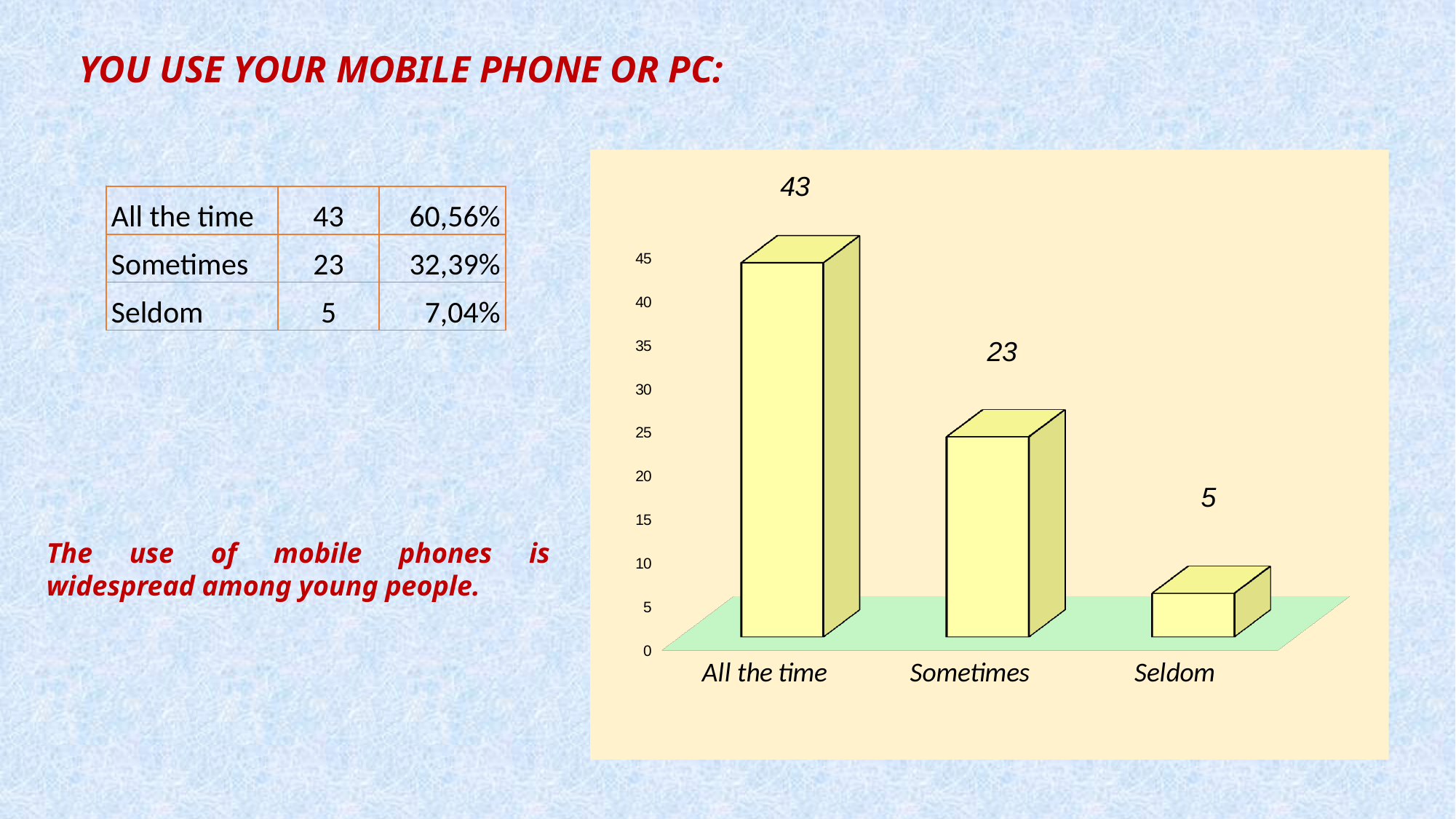
What is the value for "Sometimes"? 23 What is the difference between the values for "Sometimes" and "Seldom"? 18 Do the values rise or fall from left to right along the x axis? fall Which category has the highest value? All the time What kind of chart is shown on the slide? bar chart Which category has the lowest value? Seldom Is the value for "All the time" greater or less than 40? greater What is the value for "All the time"? 43 What is the difference between the values for "All the time" and "Sometimes"? 20 How many categories are shown on the chart? 3 What is the value for "Seldom"? 5 Which is larger, the value for "Sometimes" or the value for "Seldom"? Sometimes